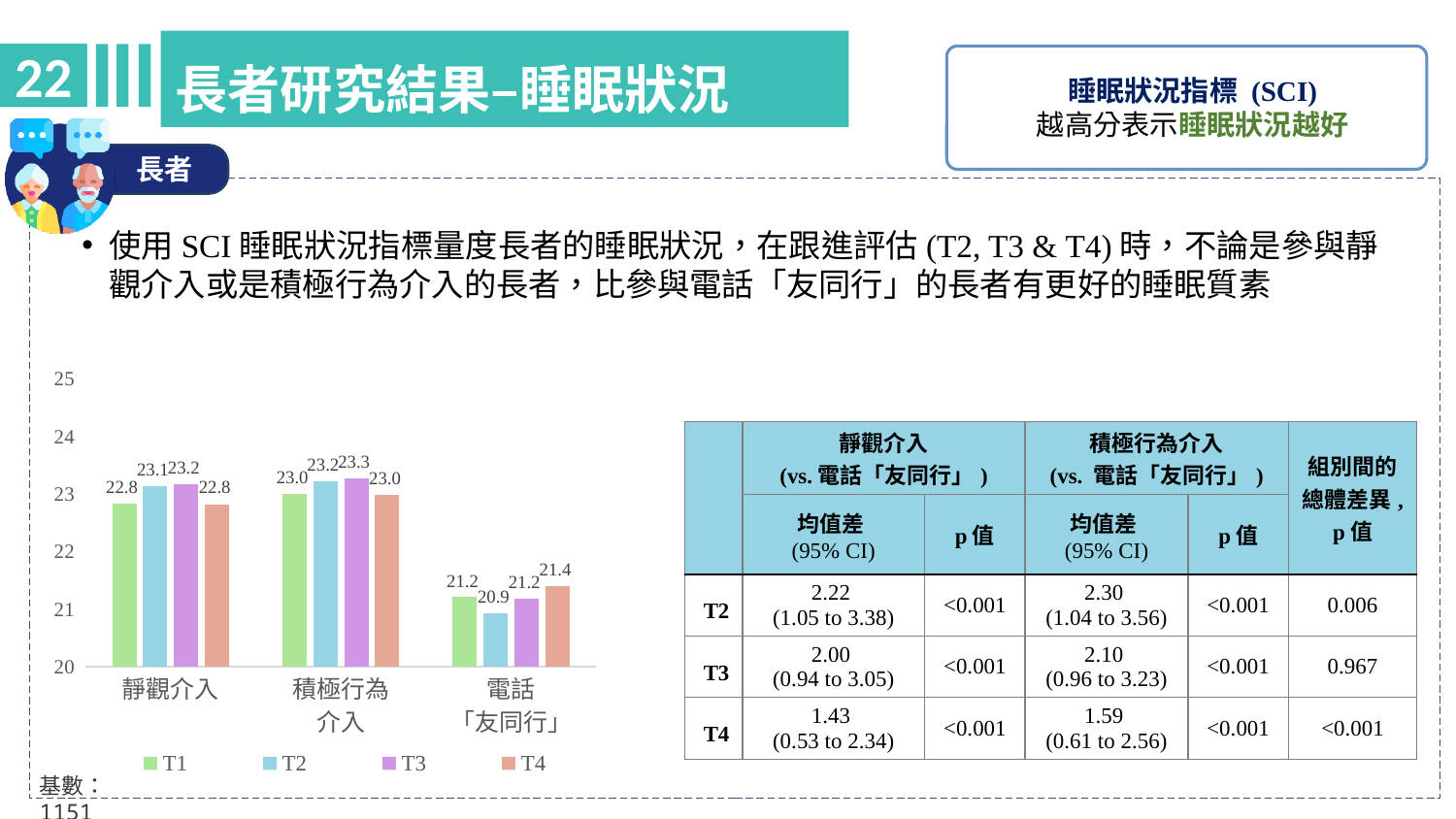
What is the T1 value for 靜觀介入? 22.8 Is the T2 value for 電話「友同行」 greater or less than 21? less What is the T2 value for 電話「友同行」? 20.9 What is the T3 value for 積極行為介入? 23.3 What kind of chart is shown on the slide? bar chart Which category has the highest T2 value? 積極行為介入 Which category has the lowest T3 value? 電話「友同行」 Which is larger: the T4 value for 靜觀介入 or the T4 value for 電話「友同行」? 靜觀介入 How many categories are shown on the x axis of the chart? 3 What is the difference between the T3 value for 積極行為介入 and the T3 value for 電話「友同行」? 2.1 How many series does the chart legend list? 4 What is the T4 value for 電話「友同行」? 21.4